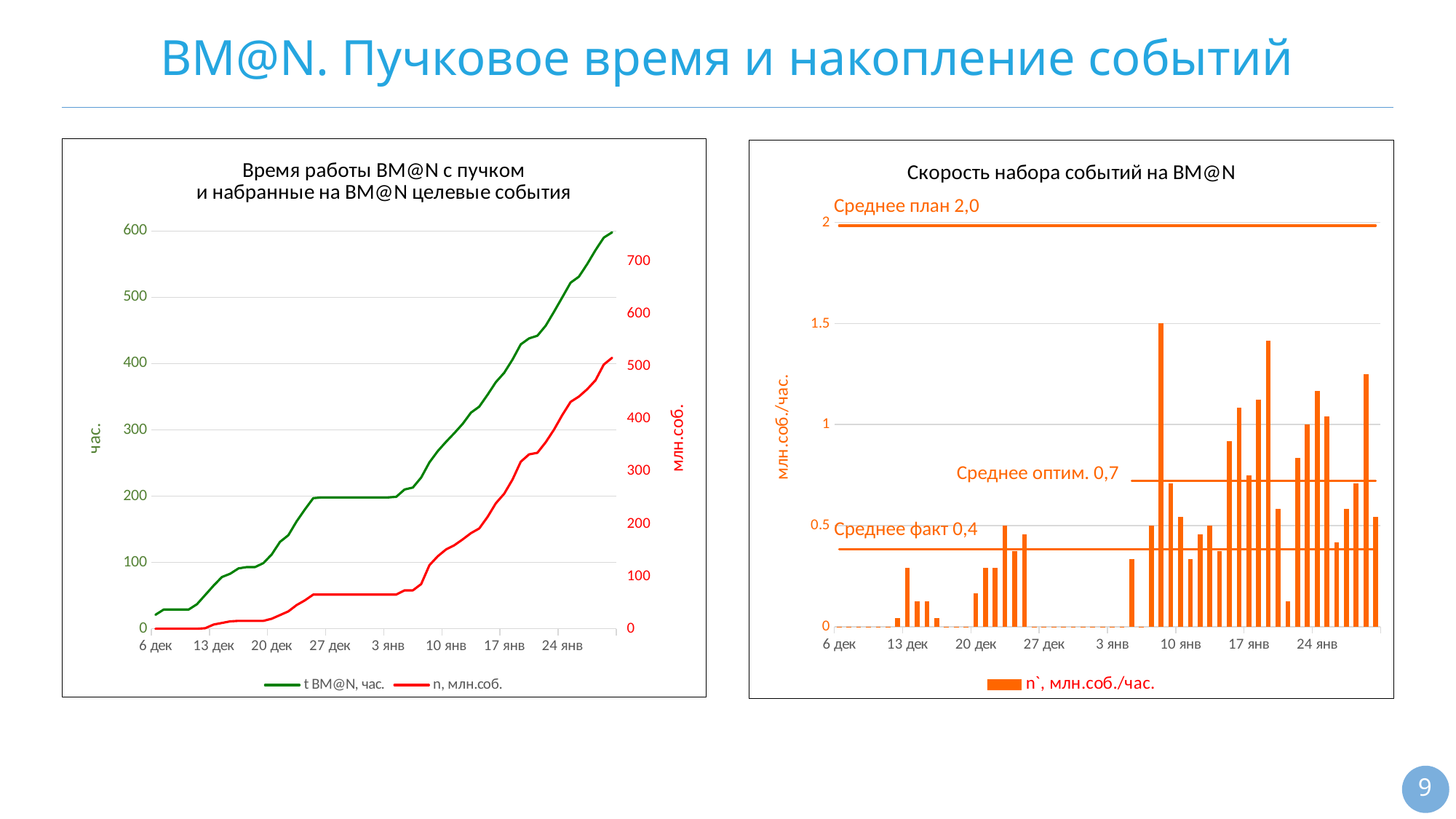
How many series does the legend of the right chart list? 1 In the right chart, what is the difference between 'Среднее план' and 'Среднее факт'? 1,6 In the left chart, is the value of 't BM@N, час.' at 13 дек greater or less than 100? less In the left chart, do the values of 't BM@N, час.' rise or fall from 6 дек to the end of the period? rise What kind of chart is the right chart, 'Скорость набора событий на BM@N'? bar chart In the right chart, what value is given for 'Среднее факт'? 0,4 In the right chart, what value is given for 'Среднее план'? 2,0 How many series does the legend of the left chart list? 2 What kind of chart is the left chart, 'Время работы BM@N с пучком и набранные на BM@N целевые события'? line chart In the left chart, is the value of 'n, млн.соб.' at 3 янв greater or less than 100? less In the left chart, is the value of 't BM@N, час.' at 24 янв greater or less than 400? greater